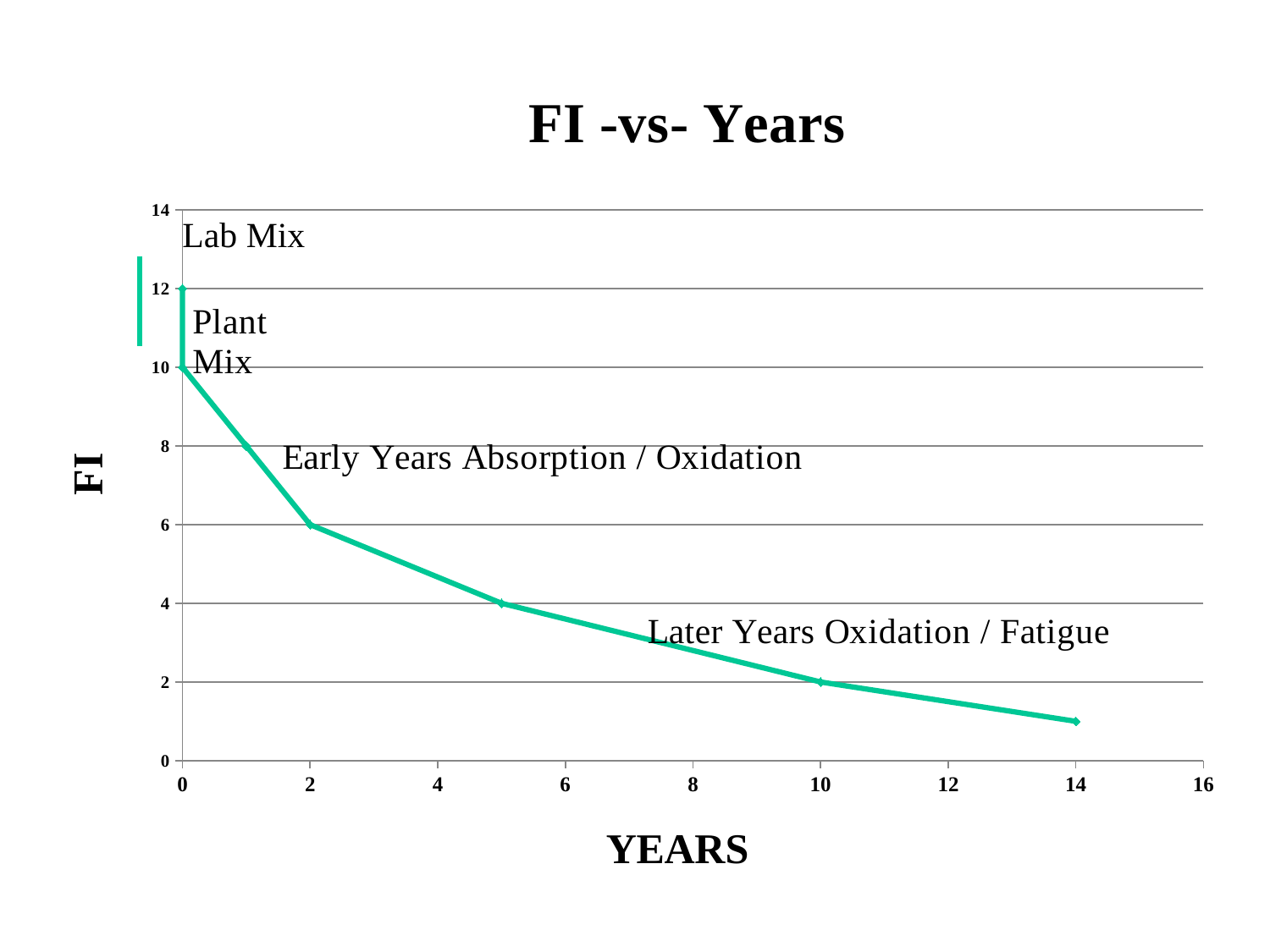
What is the FI value at 10 years? 2 What annotation is written next to the steep early part of the line? Early Years Absorption / Oxidation What is the difference between the FI value at 2 years and the FI value at 10 years? 4 What is the FI value at 2 years? 6 What kind of chart is shown on the slide? line chart Is the FI value at 14 years greater or less than 2? less What is the title of the chart? FI -vs- Years Does the FI value rise or fall as the years increase? fall What is the FI value at 5 years? 4 What FI value is labelled "Plant Mix" at year 0? 10 What FI value is labelled "Lab Mix" at year 0? 12 Which has the higher FI value, 2 years or 10 years? 2 years